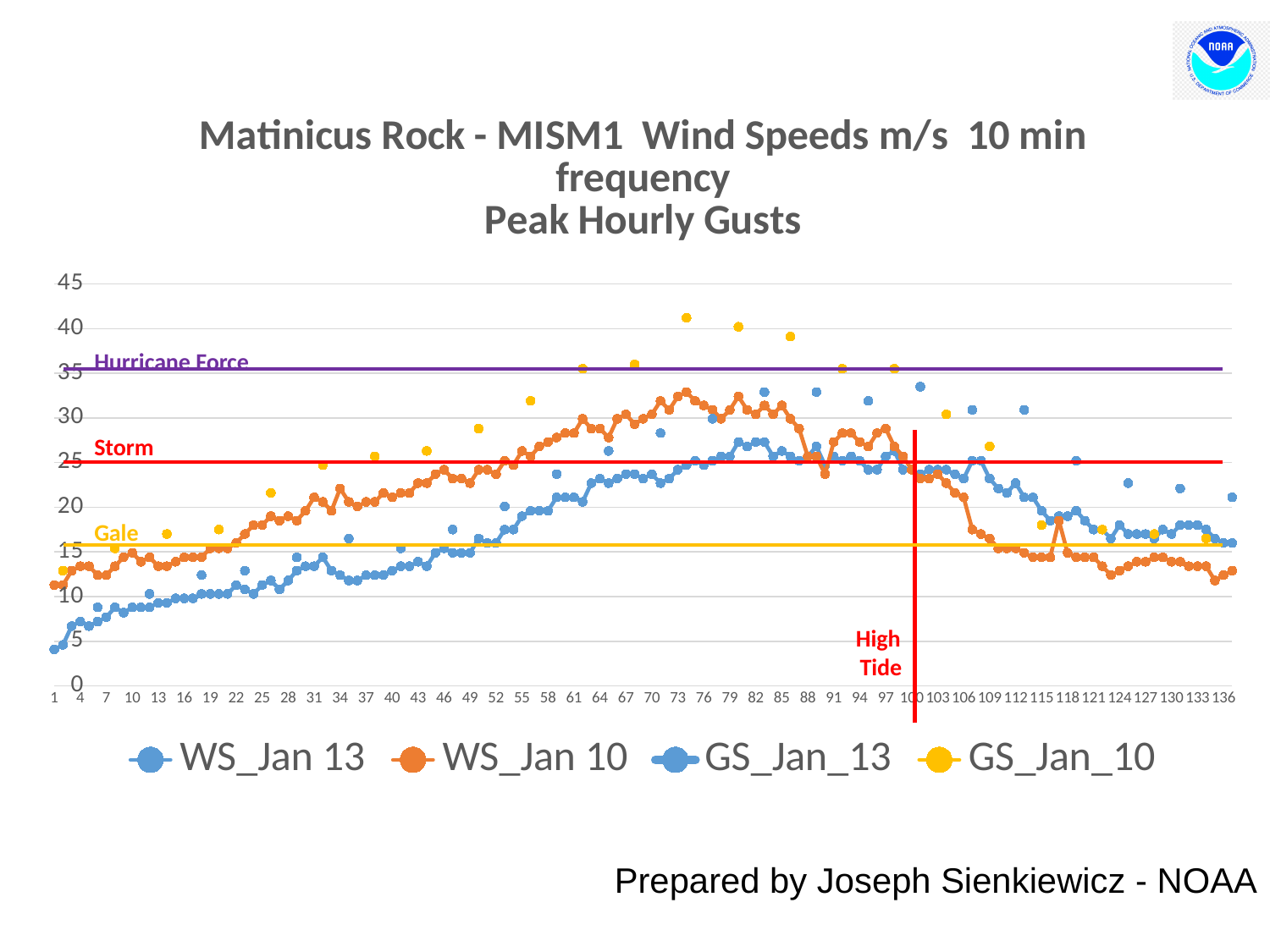
How many series does the legend list? 4 Which series reaches the highest value on the chart? GS_Jan_10 At x = 73, which is larger: WS_Jan 10 or WS_Jan 13? WS_Jan 10 What kind of chart is shown on the slide? Line chart Is the value for WS_Jan 13 at x = 1 greater or less than 10? less Does the WS_Jan 10 series generally rise or fall between x = 1 and x = 73? rise Is the value for WS_Jan 13 at x = 136 greater or less than 20? less What is the title of the chart? Matinicus Rock - MISM1 Wind Speeds m/s 10 min frequency Peak Hourly Gusts Is the value for GS_Jan_10 at x = 73 greater or less than 35? greater Does the WS_Jan 13 series generally rise or fall between x = 100 and x = 136? fall What label is attached to the vertical red line near x = 100? High Tide